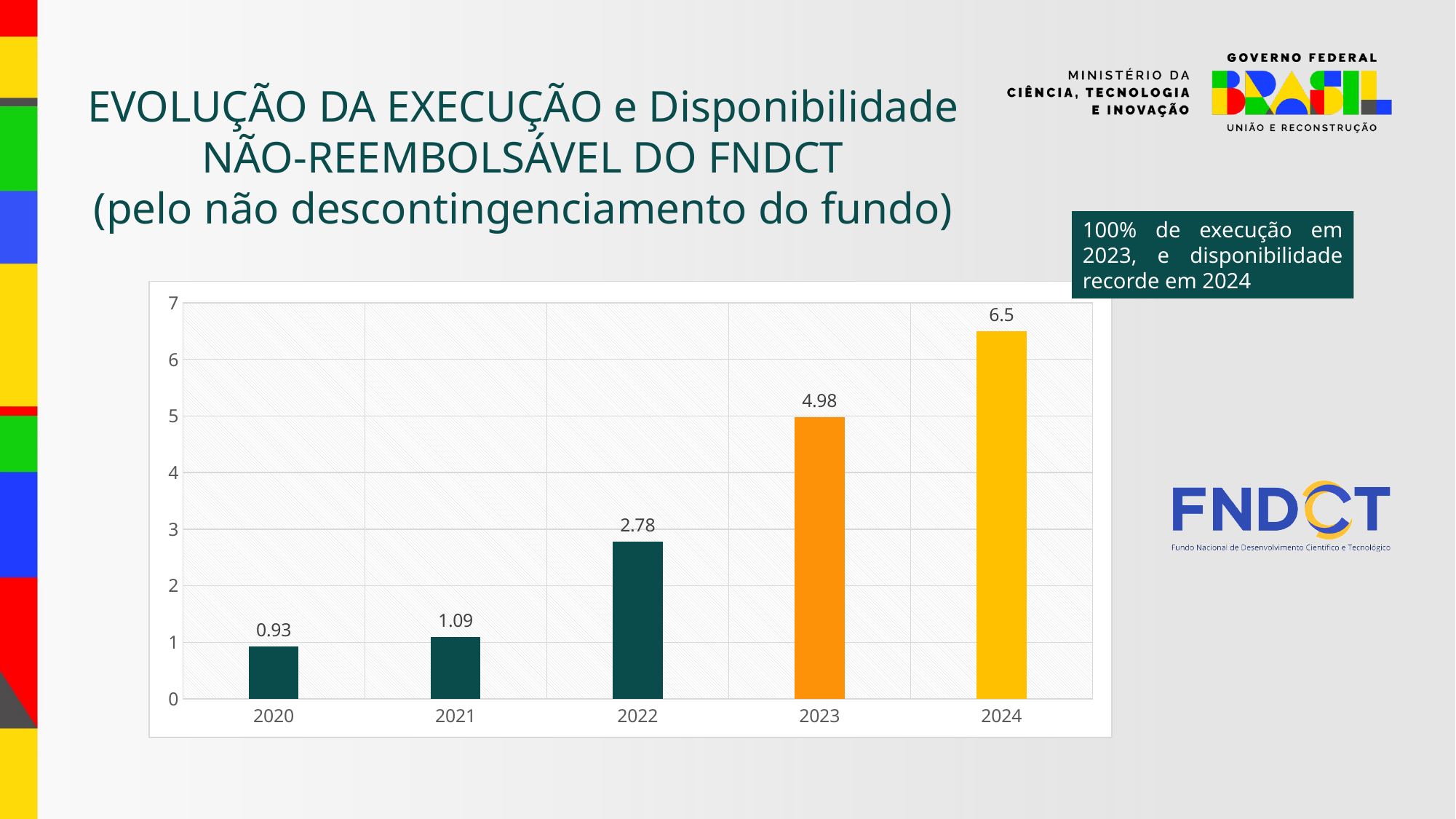
What is the difference between the values for 2024 and 2023? 1.52 What is the value for 2024? 6.5 What kind of chart is shown? bar chart Which year has the lowest value? 2020 Which year has the highest value? 2024 How many years are shown on the x axis? 5 Which is larger, the value for 2021 or the value for 2022? 2022 What is the value for 2023? 4.98 Do the values rise or fall from 2020 to 2024? rise What is the value for 2020? 0.93 What is the value for 2022? 2.78 What is the difference between the values for 2022 and 2021? 1.69